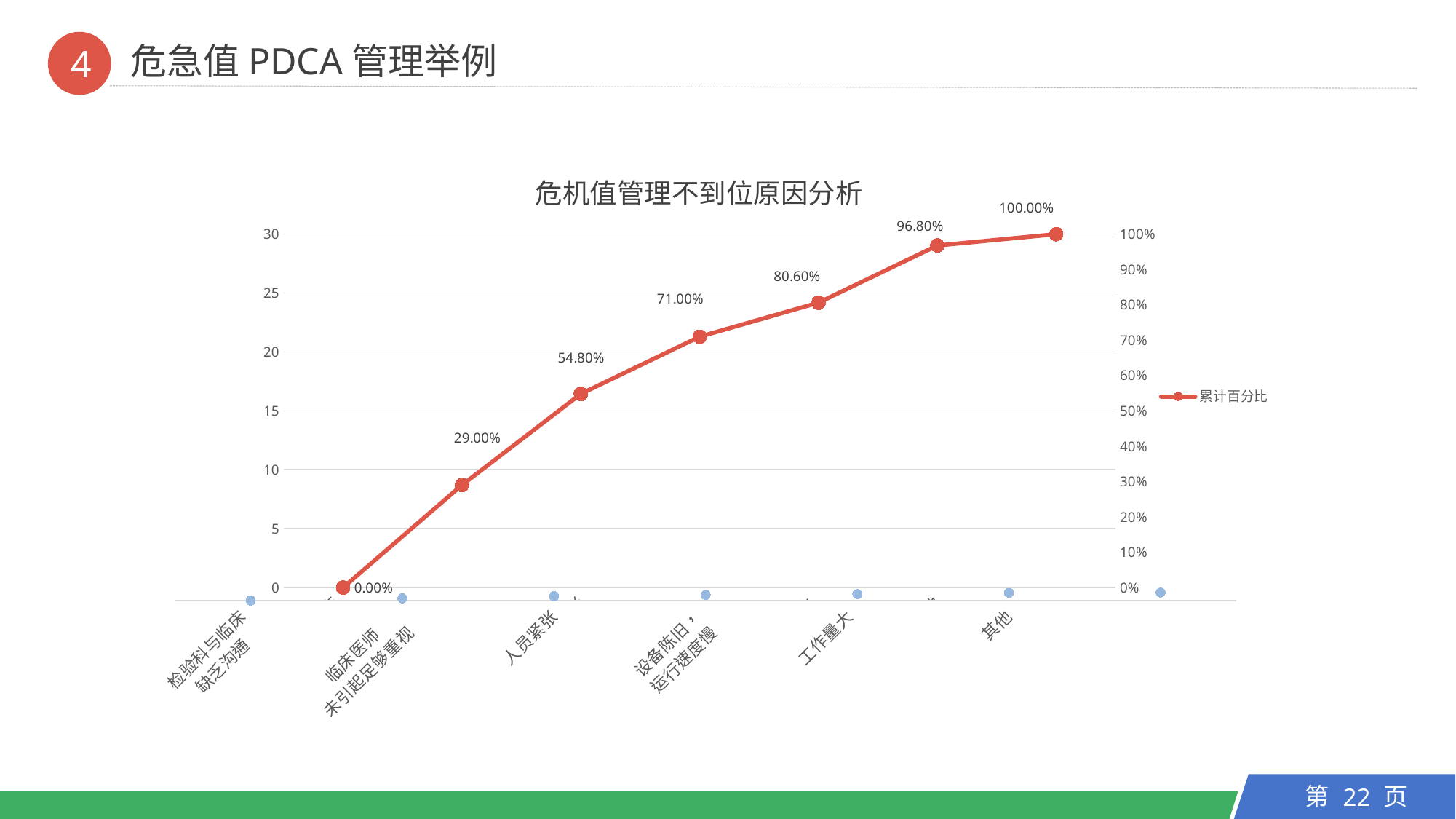
What is the value of the second data point on the 累计百分比 line? 29.00% How many series does the legend list? 1 What kind of chart is shown on the slide? line chart How many labelled data points are on the 累计百分比 line? 7 What series does the chart legend list? 累计百分比 What is the value of the first data point on the 累计百分比 line? 0.00% What is the lowest value shown on the 累计百分比 line? 0.00% Do the values on the 累计百分比 line rise or fall from left to right? rise What is the highest value shown on the 累计百分比 line? 100.00% What is the difference between the 96.80% point and the 100.00% point on the 累计百分比 line? 3.20% What is the value of the last data point on the 累计百分比 line? 100.00% What is the title of the chart? 危机值管理不到位原因分析